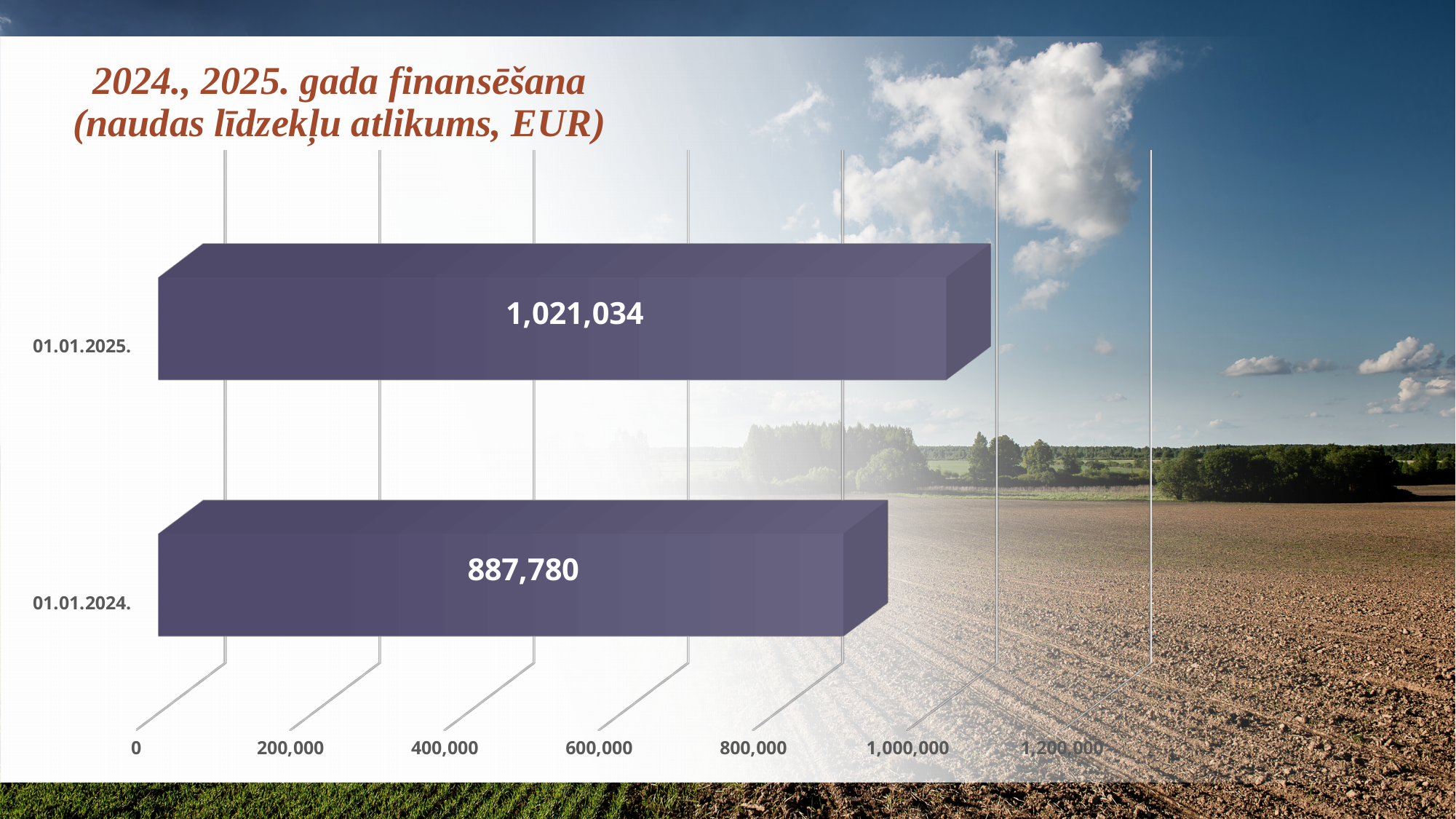
Which category has the highest value? 01.01.2025. What is the value for 01.01.2024.? 887,780 Is the value for 01.01.2024. greater or less than 1,000,000? less Is the value for 01.01.2025. greater or less than 1,000,000? greater What is the difference between the values for 01.01.2025. and 01.01.2024.? 133,254 What is the value for 01.01.2025.? 1,021,034 How many categories are shown in the chart? 2 What is the title of the chart? 2024., 2025. gada finansēšana (naudas līdzekļu atlikums, EUR) What is the highest value labelled on the horizontal axis? 1,200,000 What kind of chart is shown on the slide? bar chart Which category has the lowest value? 01.01.2024. Which is larger, the value for 01.01.2025. or the value for 01.01.2024.? 01.01.2025.